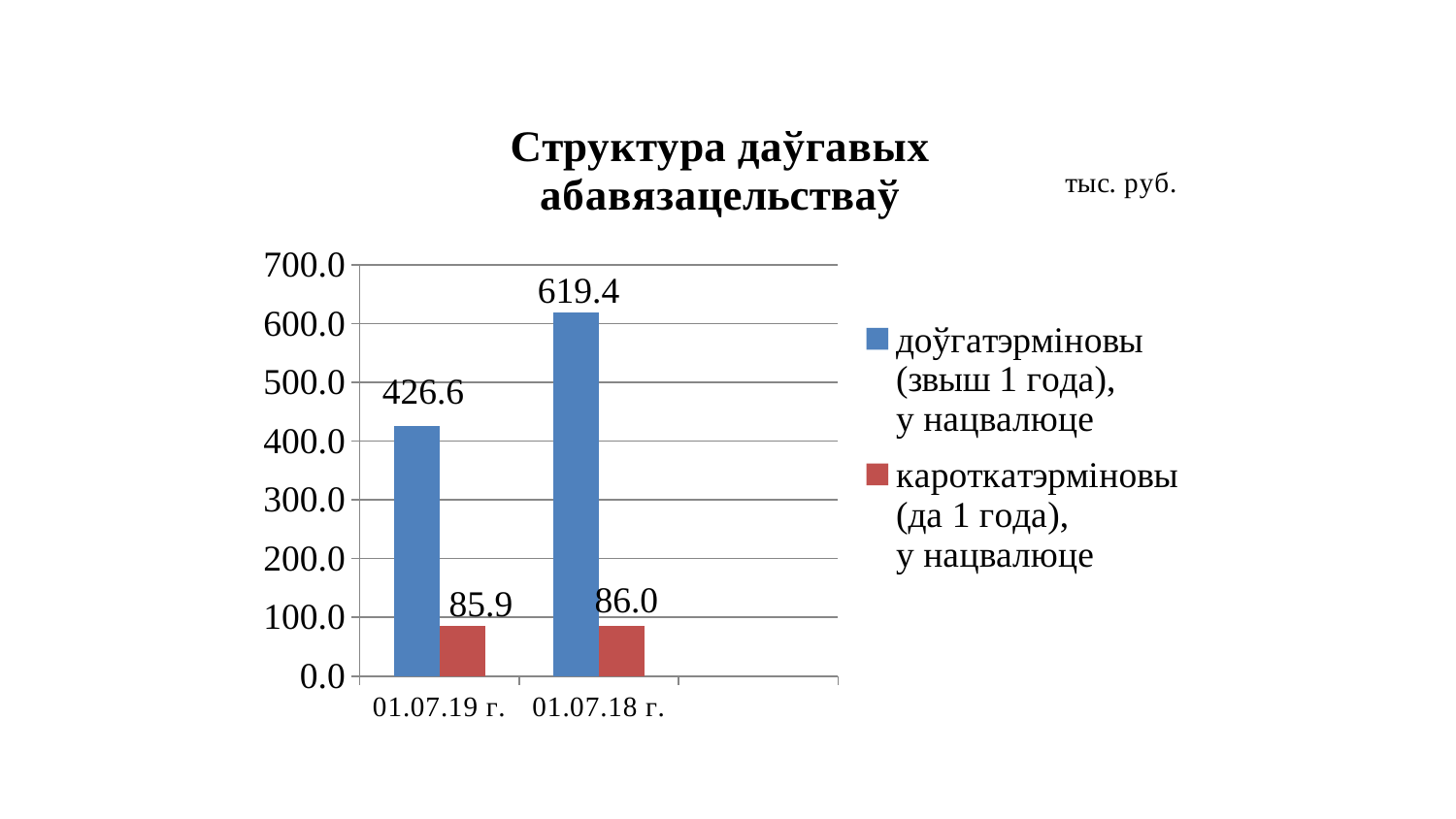
What is the value of the short-term (кароткатэрміновы) series for 01.07.19 г.? 85.9 What is the value of the long-term (доўгатэрміновы) series for 01.07.18 г.? 619.4 How many series does the legend list? 2 Is the long-term value for 01.07.18 г. greater or less than 600.0? greater What is the value of the short-term (кароткатэрміновы) series for 01.07.18 г.? 86.0 What unit is indicated for the chart values? тыс. руб. How many dates (categories) are shown on the x axis? 2 Which is larger for 01.07.19 г.: the long-term value or the short-term value? the long-term value (426.6) Which date has the higher value for the long-term (доўгатэрміновы) series? 01.07.18 г. What is the value of the long-term (доўгатэрміновы) series for 01.07.19 г.? 426.6 What is the difference between the long-term values for 01.07.18 г. and 01.07.19 г.? 192.8 What kind of chart is shown on the slide? bar chart